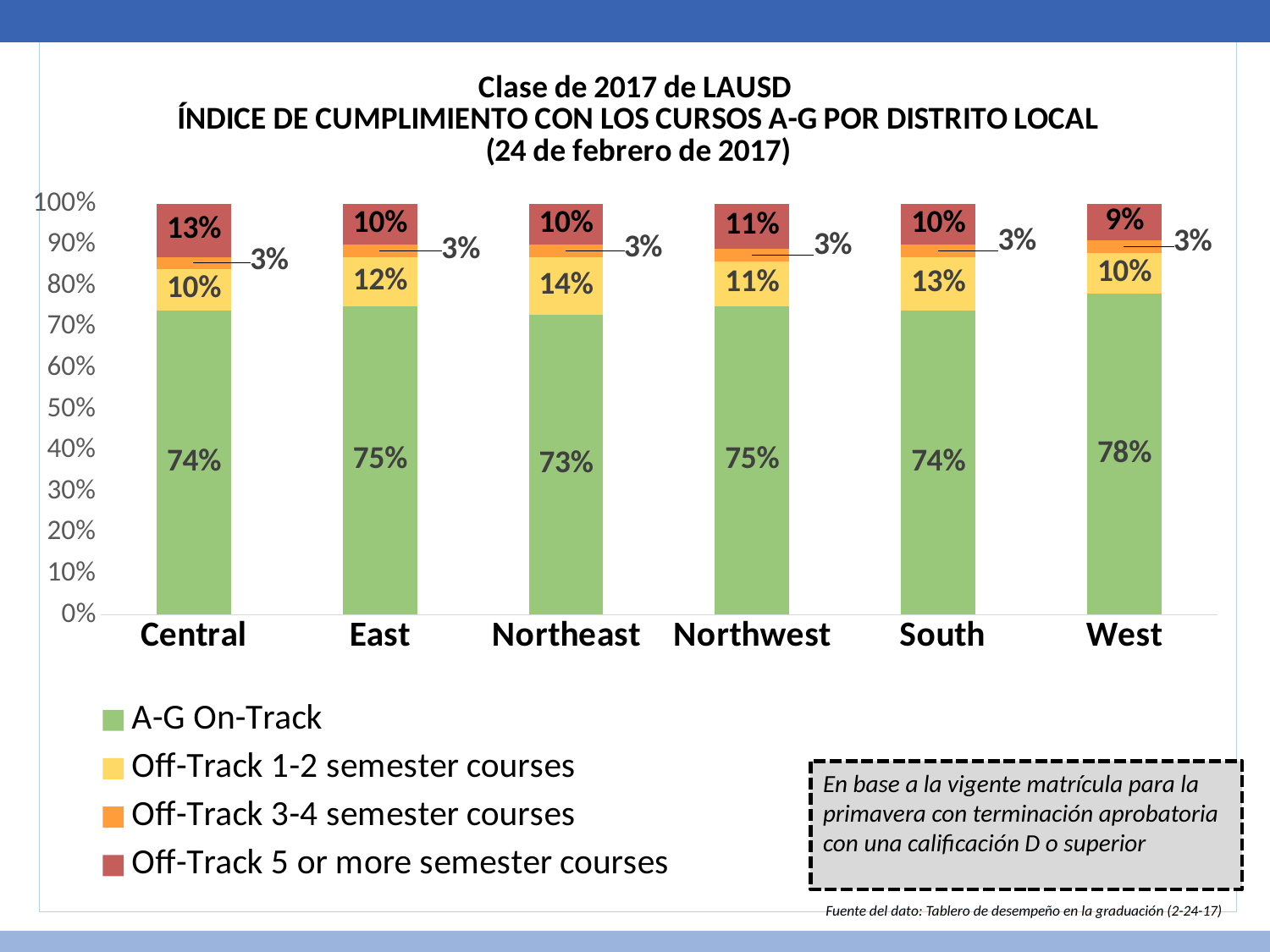
Which local district has the highest A-G On-Track value? West What kind of chart is shown on the slide? Stacked bar chart What is the A-G On-Track value for West? 78% Which local district has the lowest A-G On-Track value? Northeast How many series does the legend list? 4 What is the difference between the A-G On-Track values for West and Northeast? 5% Which is larger, the Off-Track 1-2 semester courses value for East or for South? South How many local districts are shown on the x axis? 6 What is the Off-Track 5 or more semester courses value for Central? 13% Which legend entry is shown in green? A-G On-Track What is the Off-Track 3-4 semester courses value for South? 3% What is the Off-Track 1-2 semester courses value for Northeast? 14%